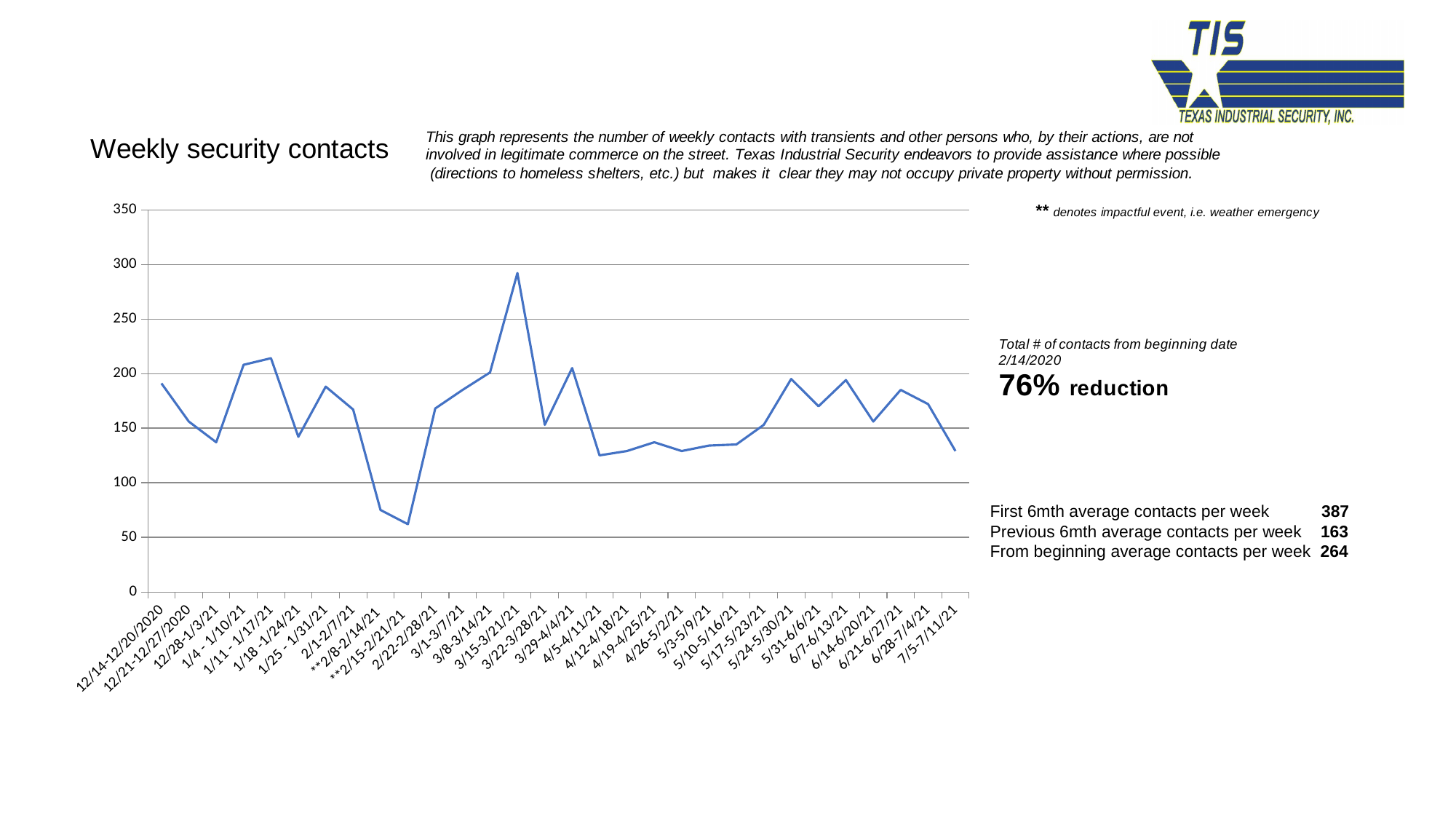
Is the value for 4/5-4/11/21 greater or less than 150? less Is the value for 12/14-12/20/2020 greater or less than 150? greater Which week has more contacts, 3/15-3/21/21 or 3/22-3/28/21? 3/15-3/21/21 Is the value for 3/15-3/21/21 greater or less than 250? greater Which week has the lowest number of contacts? **2/15-2/21/21 Which week has the highest number of contacts? 3/15-3/21/21 According to the note on the slide, what does ** next to a week label denote? impactful event, i.e. weather emergency How many weekly periods are plotted along the x axis? 30 What kind of chart is shown on the slide? line chart Which week has more contacts, 1/11-1/17/21 or 1/18-1/24/21? 1/11-1/17/21 What is the title of the chart? Weekly security contacts